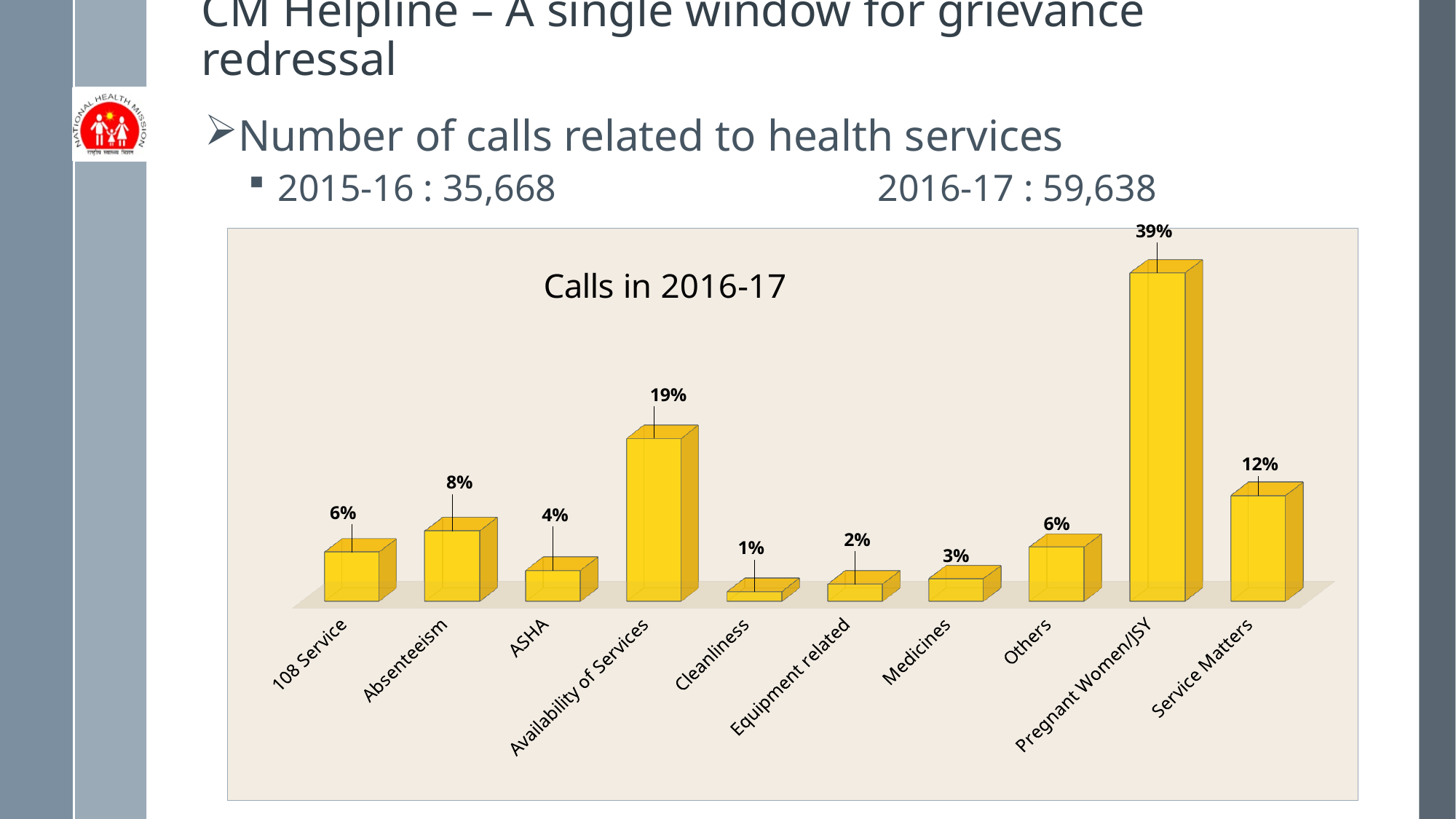
What is the value for Availability of Services? 19% What is the title of the chart? Calls in 2016-17 What is the value for Cleanliness? 1% Which is larger, the value for Absenteeism or the value for ASHA? Absenteeism What is the value for Service Matters? 12% What is the difference between the values for Medicines and Equipment related? 1% What kind of chart is shown on the slide? Bar chart How many categories are shown in the chart? 10 Which category has the highest value? Pregnant Women/JSY What is the value for Pregnant Women/JSY? 39% Which category has the lowest value? Cleanliness What is the difference between the values for Pregnant Women/JSY and Availability of Services? 20%